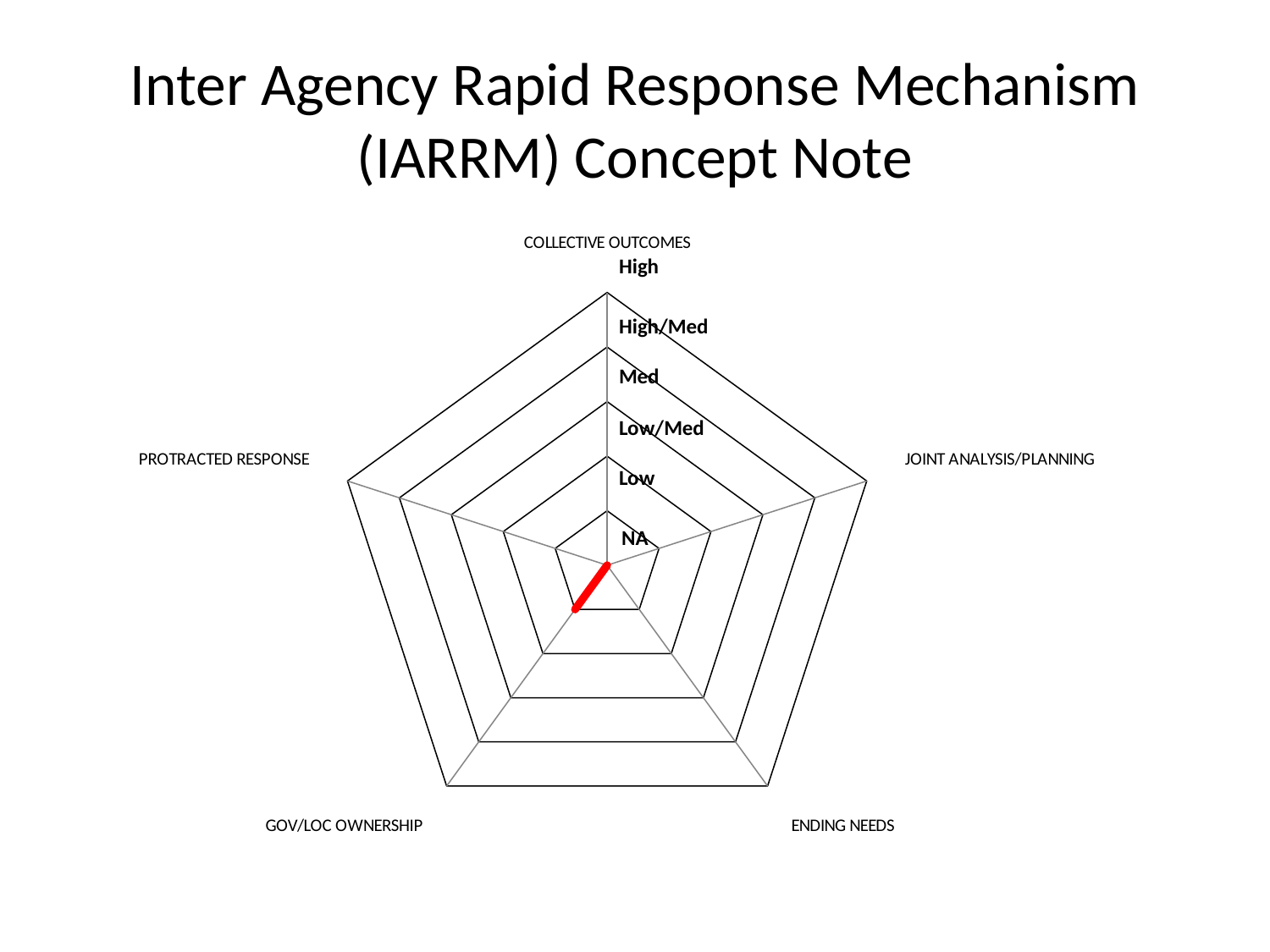
What kind of chart is shown on the slide? Radar chart What scale level lies between Med and High on the radar chart? High/Med How many levels are marked on the radar chart's scale? 6 What colour is the plotted line on the radar chart? Red Which category is at the top of the radar chart? COLLECTIVE OUTCOMES Which category is on the left side of the radar chart? PROTRACTED RESPONSE What is the highest level on the radar chart's scale? High What is the lowest level on the radar chart's scale? NA How many categories (axes) does the radar chart have? 5 Which category's axis does the red line extend along? GOV/LOC OWNERSHIP